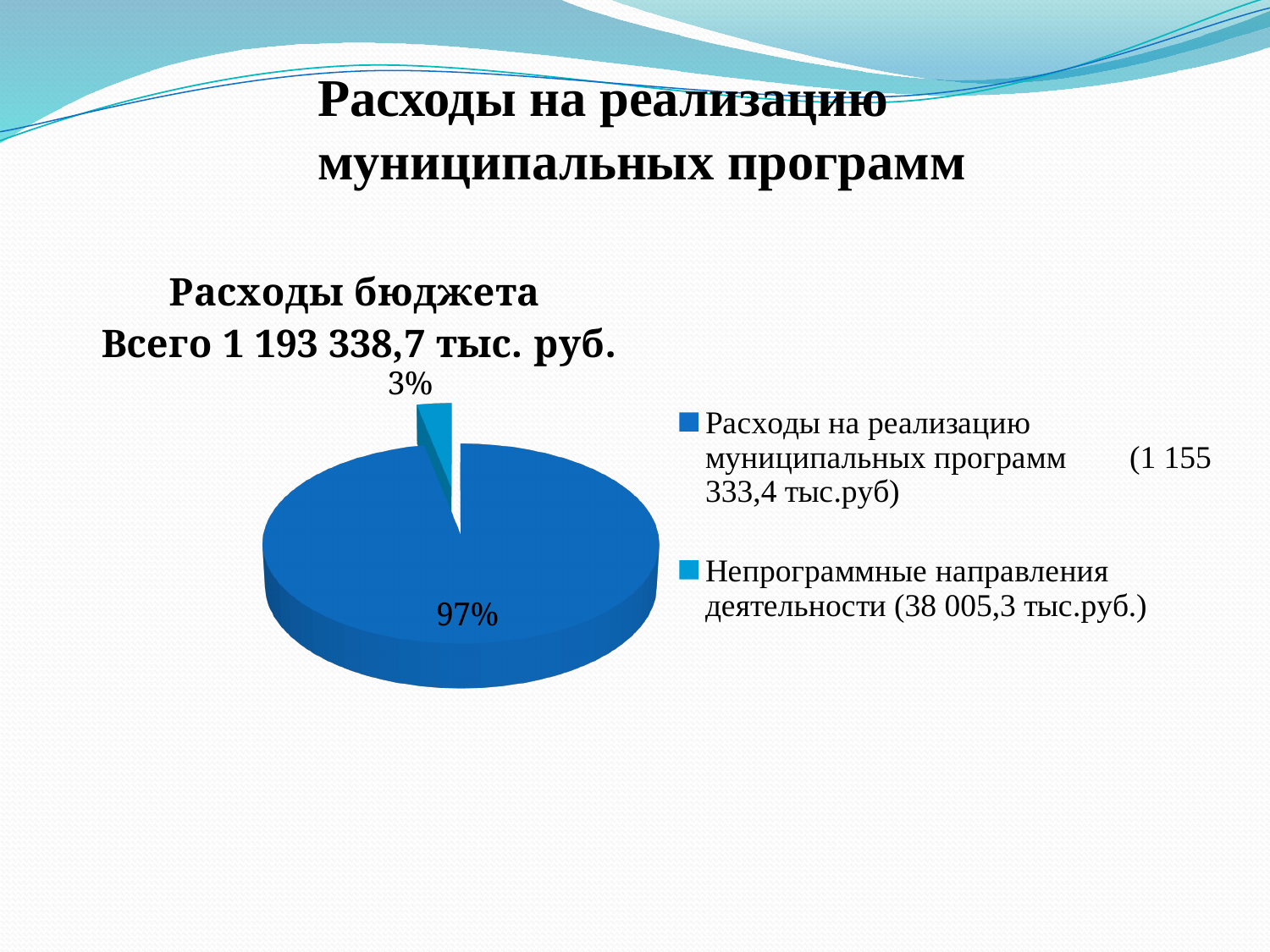
How many slices does the pie chart have? 2 What share of the pie does "Расходы на реализацию муниципальных программ" take? 97% What amount in thousand rubles does the legend give for "Расходы на реализацию муниципальных программ"? 1 155 333,4 тыс.руб Which slice of the pie is the largest? Расходы на реализацию муниципальных программ Which slice of the pie is the smallest? Непрограммные направления деятельности What total budget expenditure is stated in the chart title? 1 193 338,7 тыс. руб. What kind of chart is shown on the slide? Pie chart Which is larger: the share for "Расходы на реализацию муниципальных программ" or the share for "Непрограммные направления деятельности"? Расходы на реализацию муниципальных программ What is the difference in percentage points between the two slices of the pie? 94 percentage points How many entries does the legend list? 2 What share of the pie does "Непрограммные направления деятельности" take? 3% What amount in thousand rubles does the legend give for "Непрограммные направления деятельности"? 38 005,3 тыс.руб.